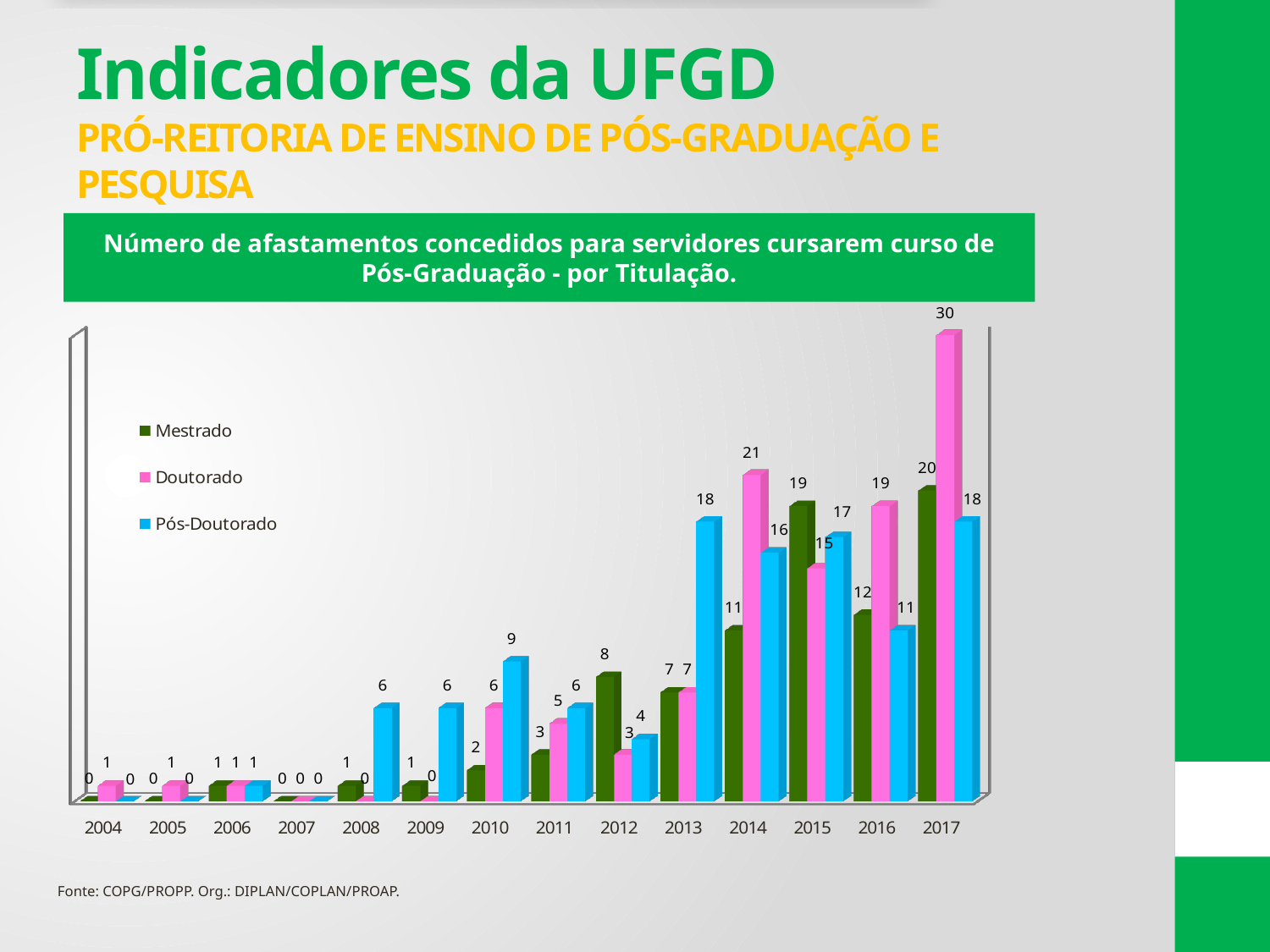
What is the total of the three series in 2017? 68 What is the difference between the Doutorado and Mestrado values in 2014? 10 What kind of chart is shown? Bar chart What is the value for Pós-Doutorado in 2013? 18 Which is larger in 2012, Mestrado or Pós-Doutorado? Mestrado What is the value for Mestrado in 2015? 19 Which series is shown in pink? Doutorado What is the value for Doutorado in 2017? 30 How many series does the legend list? 3 How many years are shown on the x axis? 14 What is the value for Pós-Doutorado in 2010? 9 In which year does Doutorado reach its highest value? 2017